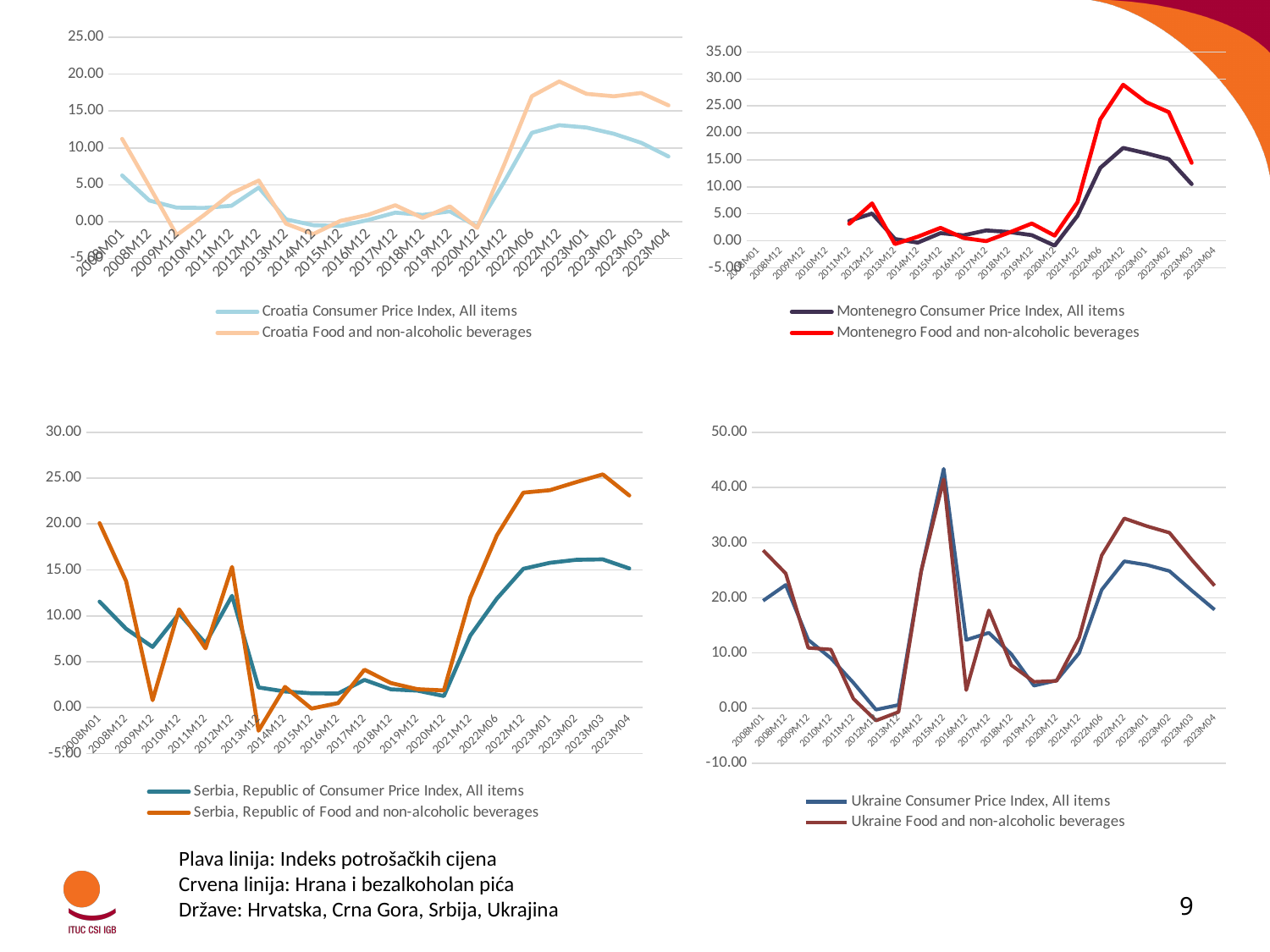
What is the second legend entry of the bottom-left chart? Serbia, Republic of Food and non-alcoholic beverages How many series does the legend of the bottom-right Ukraine chart list? 2 In the top-left Croatia chart, is the value of Croatia Food and non-alcoholic beverages at 2022M12 greater or less than 15.00? greater In the top-left Croatia chart, does Croatia Consumer Price Index, All items rise or fall from 2023M01 to 2023M04? fall In the bottom-right Ukraine chart, is the value of Ukraine Consumer Price Index, All items at 2015M12 greater or less than 40.00? greater In the bottom-left Serbia chart, is the value of Serbia, Republic of Food and non-alcoholic beverages at 2023M03 greater or less than 20.00? greater In the bottom-right Ukraine chart, at which period does Ukraine Consumer Price Index, All items reach its highest value? 2015M12 In the top-right Montenegro chart, which series has the higher value at 2022M12: Consumer Price Index, All items or Food and non-alcoholic beverages? Food and non-alcoholic beverages What kind of chart is the top-left chart showing Croatia? Line chart In the bottom-left Serbia chart, which series is higher at 2023M04: Consumer Price Index, All items or Food and non-alcoholic beverages? Food and non-alcoholic beverages